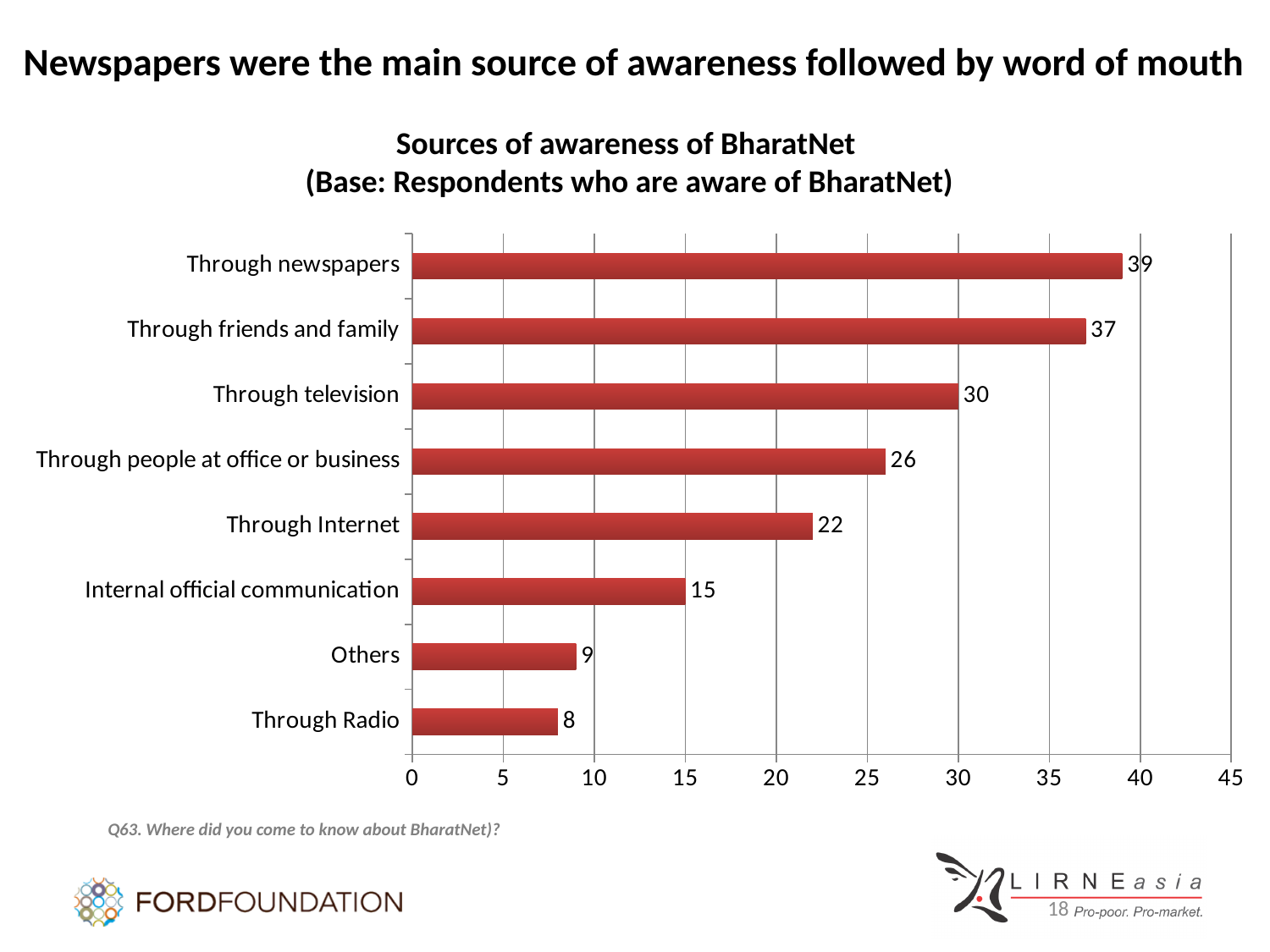
Which source of awareness has the lowest value? Through Radio How many categories are shown in the chart? 8 What is the title of the chart? Sources of awareness of BharatNet (Base: Respondents who are aware of BharatNet) What is the value for Through newspapers? 39 Which is larger, the value for Through people at office or business or the value for Through Internet? Through people at office or business Which source of awareness has the highest value? Through newspapers Is the value for Through friends and family greater or less than 35? greater What is the value for Internal official communication? 15 What is the difference between the values for Through newspapers and Through friends and family? 2 What is the value for Through television? 30 What is the difference between the values for Through television and Through Internet? 8 What kind of chart is shown on the slide? Bar chart